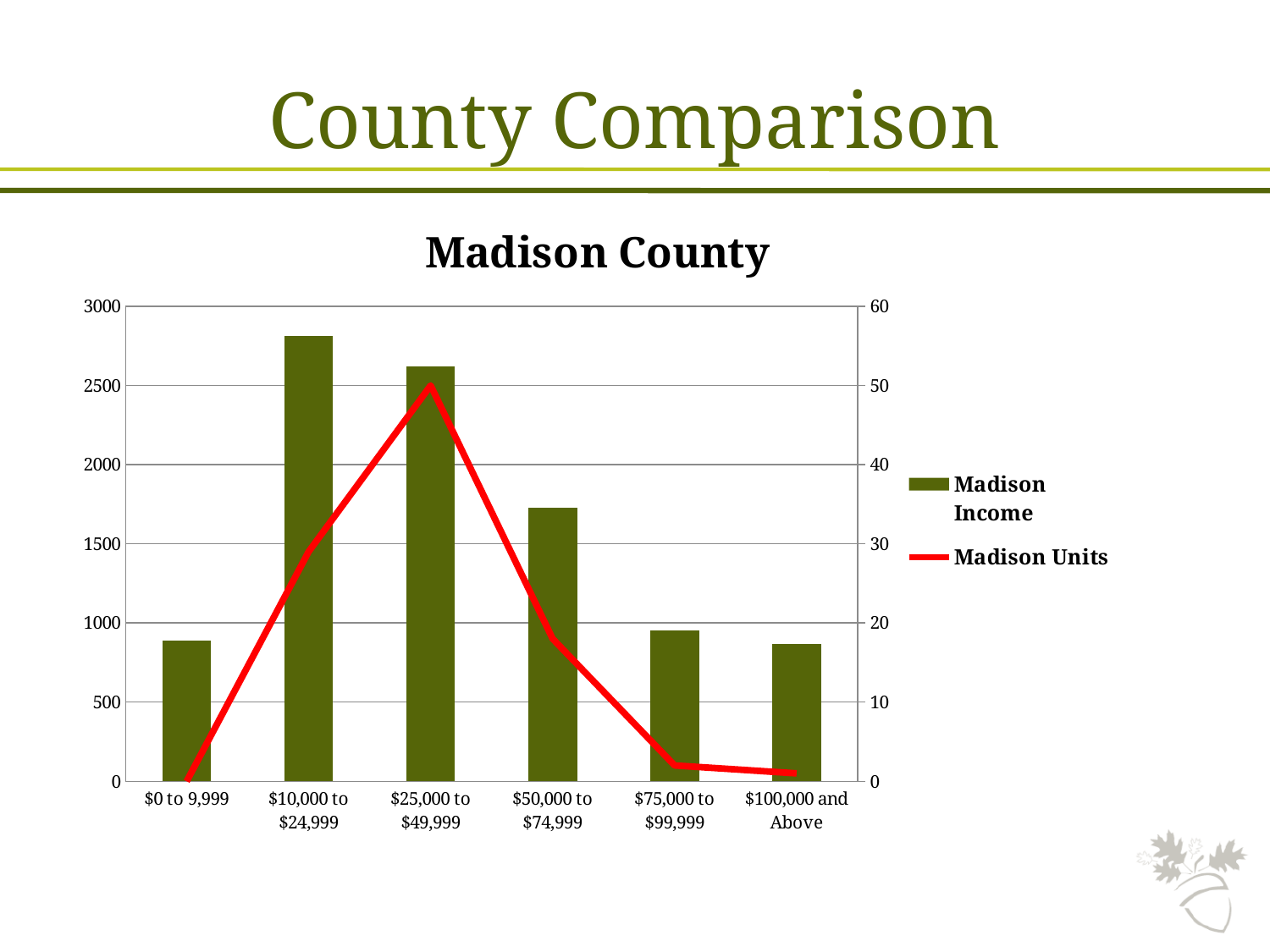
How many series does the chart's legend list? 2 Is the Madison Income value for $0 to 9,999 greater or less than 1000? less Which has the larger Madison Income value: $50,000 to $74,999 or $75,000 to $99,999? $50,000 to $74,999 How many income categories are shown on the x axis of the chart? 6 Do the Madison Units values rise or fall from $25,000 to $49,999 through $100,000 and Above? fall Which income category has the highest Madison Income bar? $10,000 to $24,999 Which income category has the lowest value for Madison Units? $0 to 9,999 Is the Madison Units value for $50,000 to $74,999 greater or less than 10? greater Which income category has the highest value for Madison Units? $25,000 to $49,999 What kind of chart is used for the Madison Income series? Bar chart Is the Madison Income value for $10,000 to $24,999 greater or less than 2500? greater What is the title of the chart on the slide? Madison County